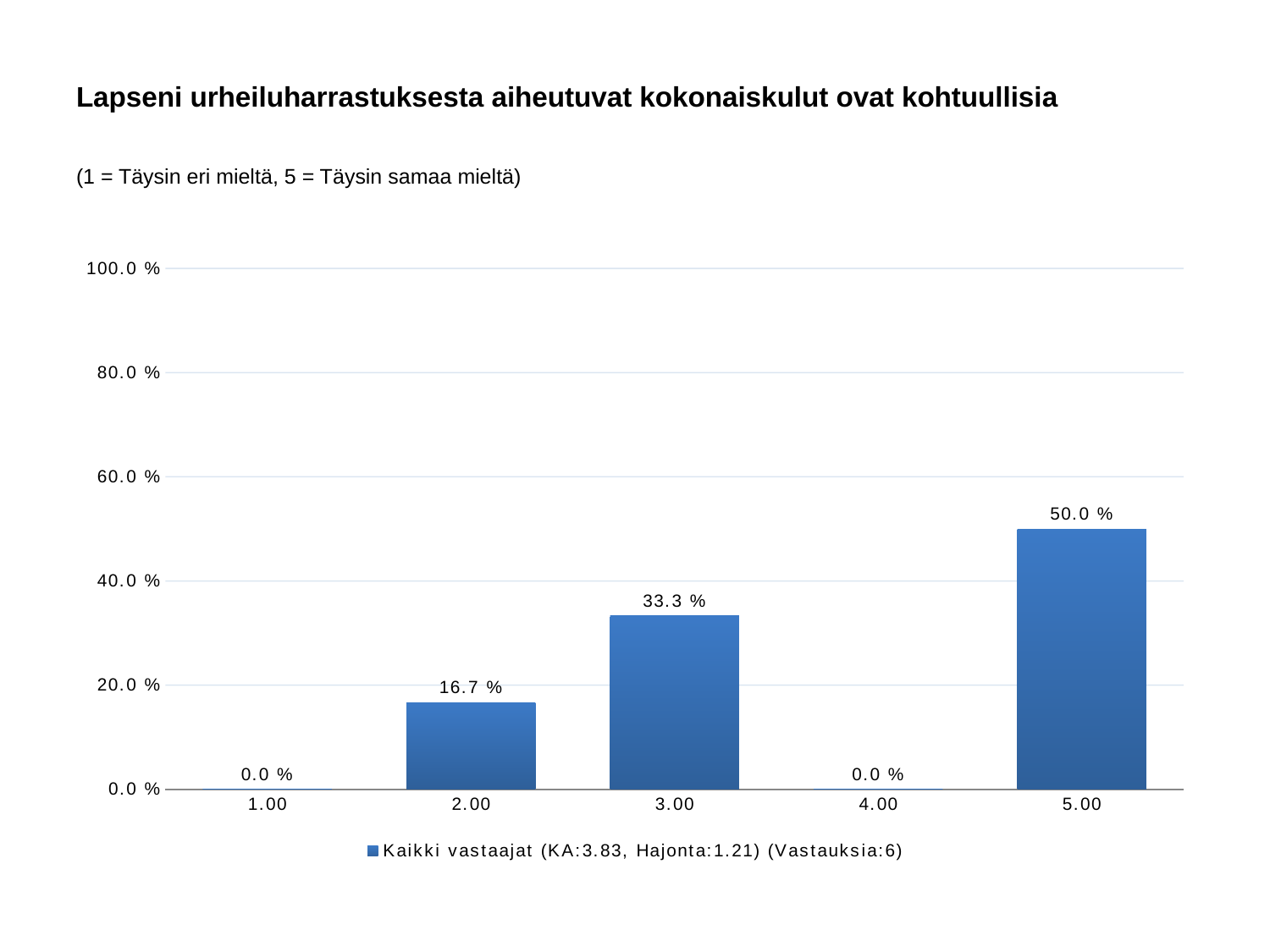
How many responses (Vastauksia) does the legend report? 6 What kind of chart is shown on the slide? bar chart Which is larger, the value for 2.00 or the value for 3.00? 3.00 Is the value for 5.00 greater or less than 40.0 %? greater What is the value for category 4.00? 0.0 % What is the difference between the values for 3.00 and 2.00? 16.6 % How many categories are shown on the x axis? 5 What is the value for category 5.00? 50.0 % What is the value for category 3.00? 33.3 % What is the difference between the values for 5.00 and 3.00? 16.7 % Which category has the highest value? 5.00 What is the value for category 2.00? 16.7 %